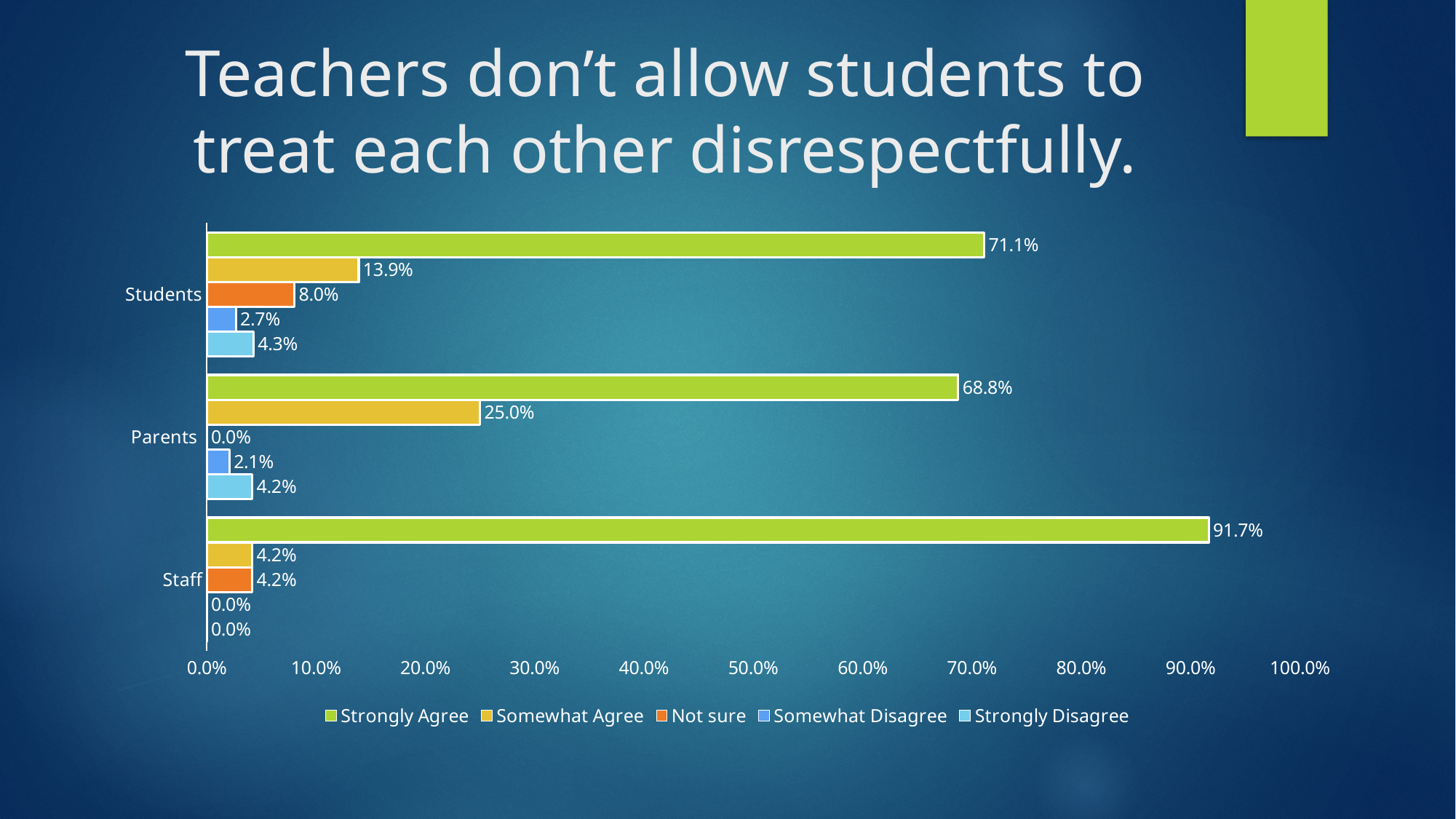
How many groups are shown on the vertical axis? 3 Which group has the highest Strongly Agree percentage? Staff What kind of chart is shown on the slide? Bar chart What is the difference between the Strongly Agree percentages for Staff and Students? 20.6% What percentage of Students answered Not sure? 8.0% Which colour represents Strongly Agree in the legend? Green What percentage of Parents somewhat agree? 25.0% What percentage of Staff strongly agree? 91.7% Which group has the lowest Somewhat Agree percentage? Staff How many series does the legend list? 5 Which is larger: the Somewhat Agree percentage for Parents or for Students? Parents What percentage of Students strongly agree? 71.1%